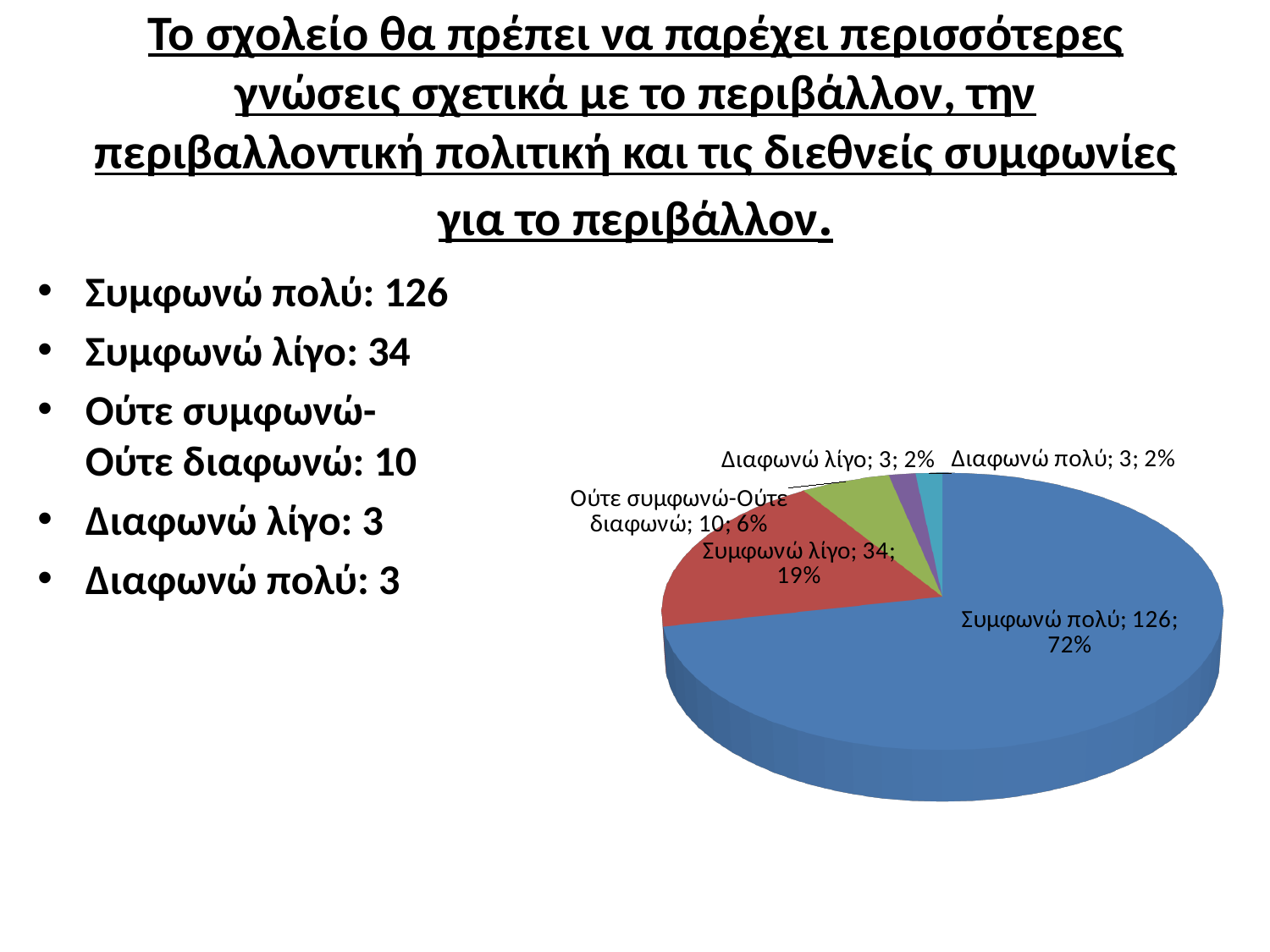
What percentage share does Συμφωνώ λίγο have in the pie chart? 19% What kind of chart is shown on the slide? pie chart What is the value for Ούτε συμφωνώ-Ούτε διαφωνώ in the pie chart? 10 What is the difference between the values for Συμφωνώ πολύ and Συμφωνώ λίγο? 92 Which is larger, the value for Συμφωνώ λίγο or the value for Ούτε συμφωνώ-Ούτε διαφωνώ? Συμφωνώ λίγο What colour is the Συμφωνώ πολύ slice in the pie chart? blue What is the value for Συμφωνώ λίγο in the pie chart? 34 What percentage share does Ούτε συμφωνώ-Ούτε διαφωνώ have in the pie chart? 6% How many slices does the pie chart have? 5 What is the value for Συμφωνώ πολύ in the pie chart? 126 What percentage share does Συμφωνώ πολύ have in the pie chart? 72% Which category has the largest slice in the pie chart? Συμφωνώ πολύ